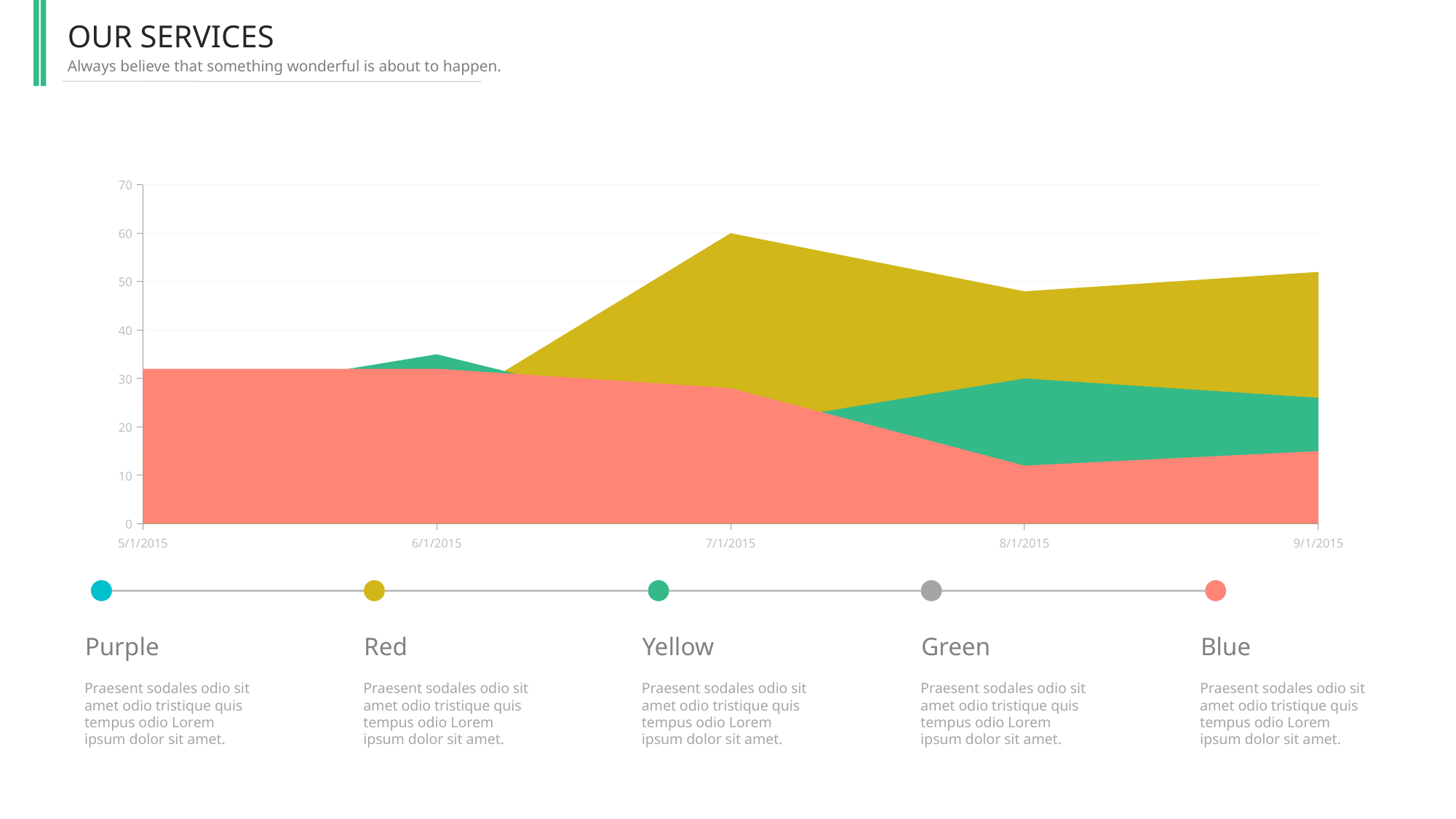
At which date does the red series reach its lowest value? 8/1/2015 Is the value of the red series at 5/1/2015 greater or less than 30? greater Is the value of the green series at 8/1/2015 greater or less than 40? less What is the highest value shown on the y axis of the chart? 70 What kind of chart is shown on the slide? area chart Is the value of the red series at 8/1/2015 greater or less than 20? less At which date does the yellow series reach its highest value? 7/1/2015 What is the first date label on the x axis of the chart? 5/1/2015 Does the red series generally rise or fall from 5/1/2015 to 9/1/2015? fall How many dates are labelled along the x axis of the chart? 5 At 9/1/2015, which series has the larger value, the yellow series or the red series? yellow